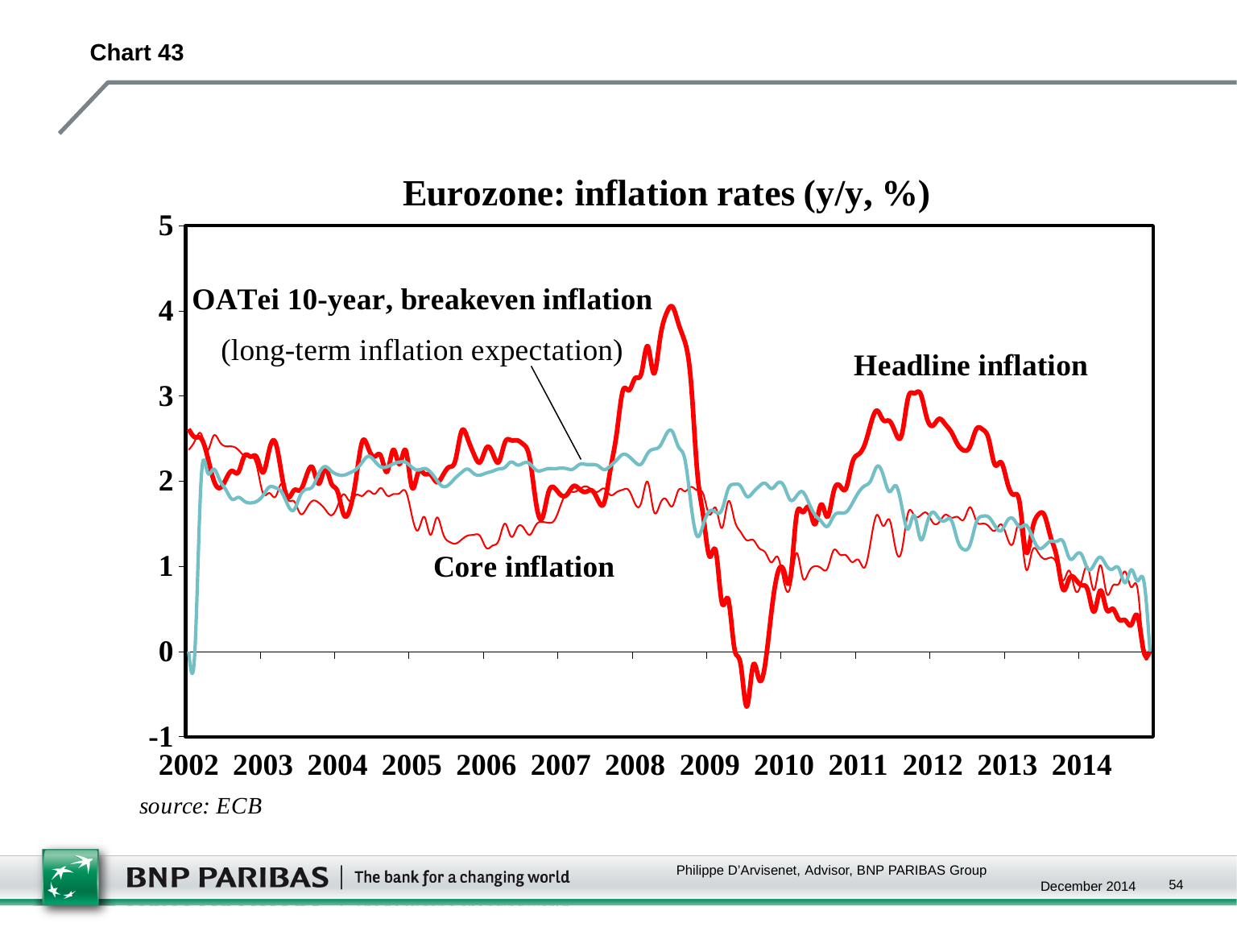
What is the title of the chart? Eurozone: inflation rates (y/y, %) In which year does Headline inflation reach its lowest point? 2009 Does Headline inflation rise or fall between 2012 and the end of 2014? fall What is the source cited below the chart? ECB Is the lowest value of Headline inflation in 2009 greater or less than 0? less How many series are plotted on the chart? 3 At the 2008 peak, which is higher: Headline inflation or the OATei 10-year breakeven inflation? Headline inflation What is the highest value shown on the vertical axis? 5 What kind of chart is shown on the slide? line chart In which year does Headline inflation reach its highest peak? 2008 Is Core inflation in 2006 greater or less than 2? less Is the peak value of Headline inflation in 2008 greater or less than 3? greater